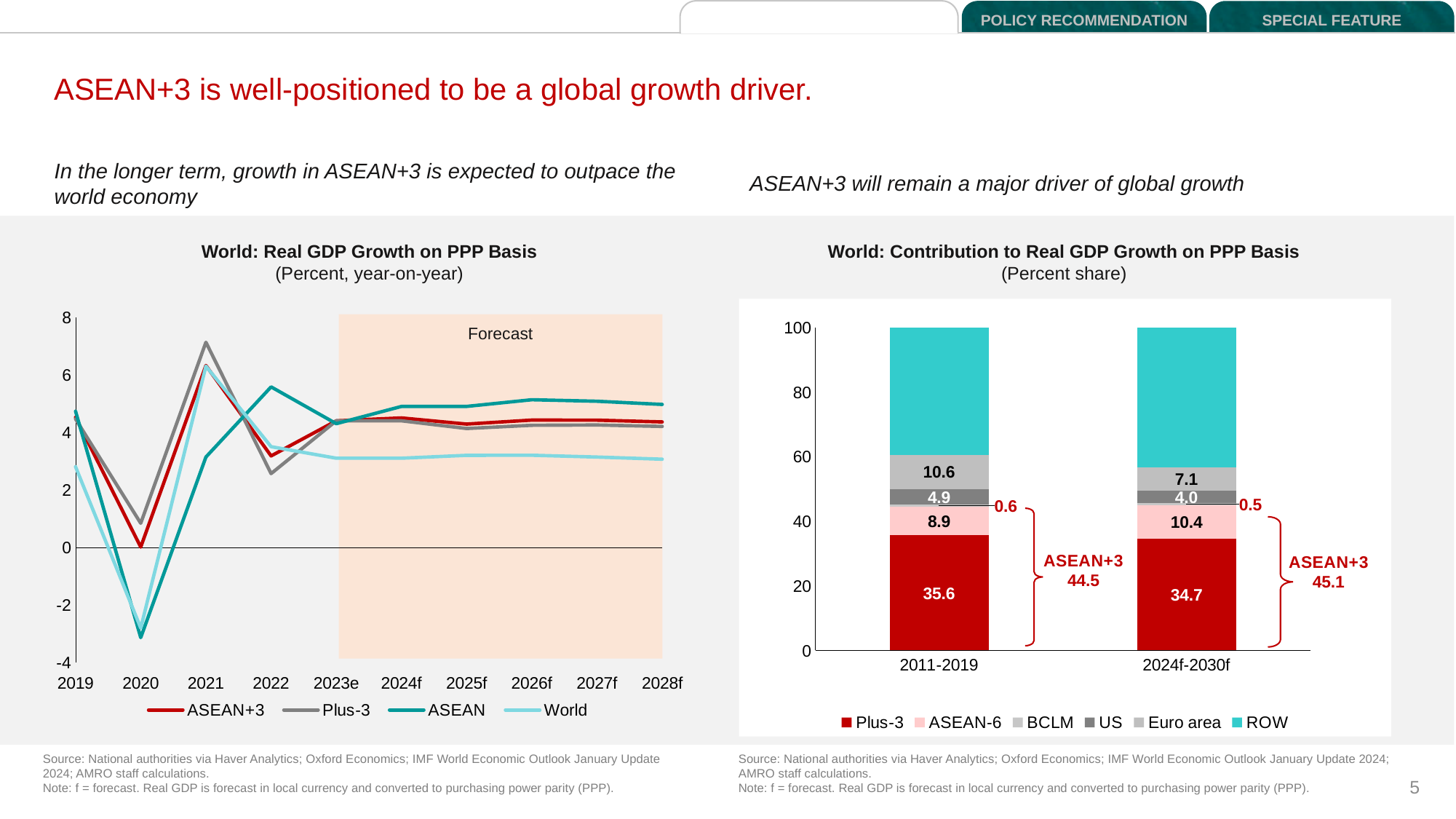
In the chart 'World: Real GDP Growth on PPP Basis', which series has the highest value in 2021? Plus-3 In the chart 'World: Contribution to Real GDP Growth on PPP Basis', what is the value for Plus-3 in 2011-2019? 35.6 In the chart 'World: Real GDP Growth on PPP Basis', is the value for World in 2028f greater or less than 4? less What kind of chart is 'World: Real GDP Growth on PPP Basis'? Line chart In the chart 'World: Real GDP Growth on PPP Basis', is the value for ASEAN in 2020 greater or less than -2? less In the chart 'World: Contribution to Real GDP Growth on PPP Basis', by how much does the Euro area value in 2011-2019 exceed its value in 2024f-2030f? 3.5 In the chart 'World: Contribution to Real GDP Growth on PPP Basis', what is the Euro area value for 2011-2019? 10.6 In the chart 'World: Contribution to Real GDP Growth on PPP Basis', what is the value for ASEAN-6 in 2024f-2030f? 10.4 In the chart 'World: Contribution to Real GDP Growth on PPP Basis', is the US value larger in 2011-2019 or in 2024f-2030f? 2011-2019 How many years are shown on the x axis of the chart 'World: Real GDP Growth on PPP Basis'? 10 In the chart 'World: Contribution to Real GDP Growth on PPP Basis', what is the ASEAN+3 share shown for 2024f-2030f? 45.1 How many series does the legend of the chart 'World: Contribution to Real GDP Growth on PPP Basis' list? 6